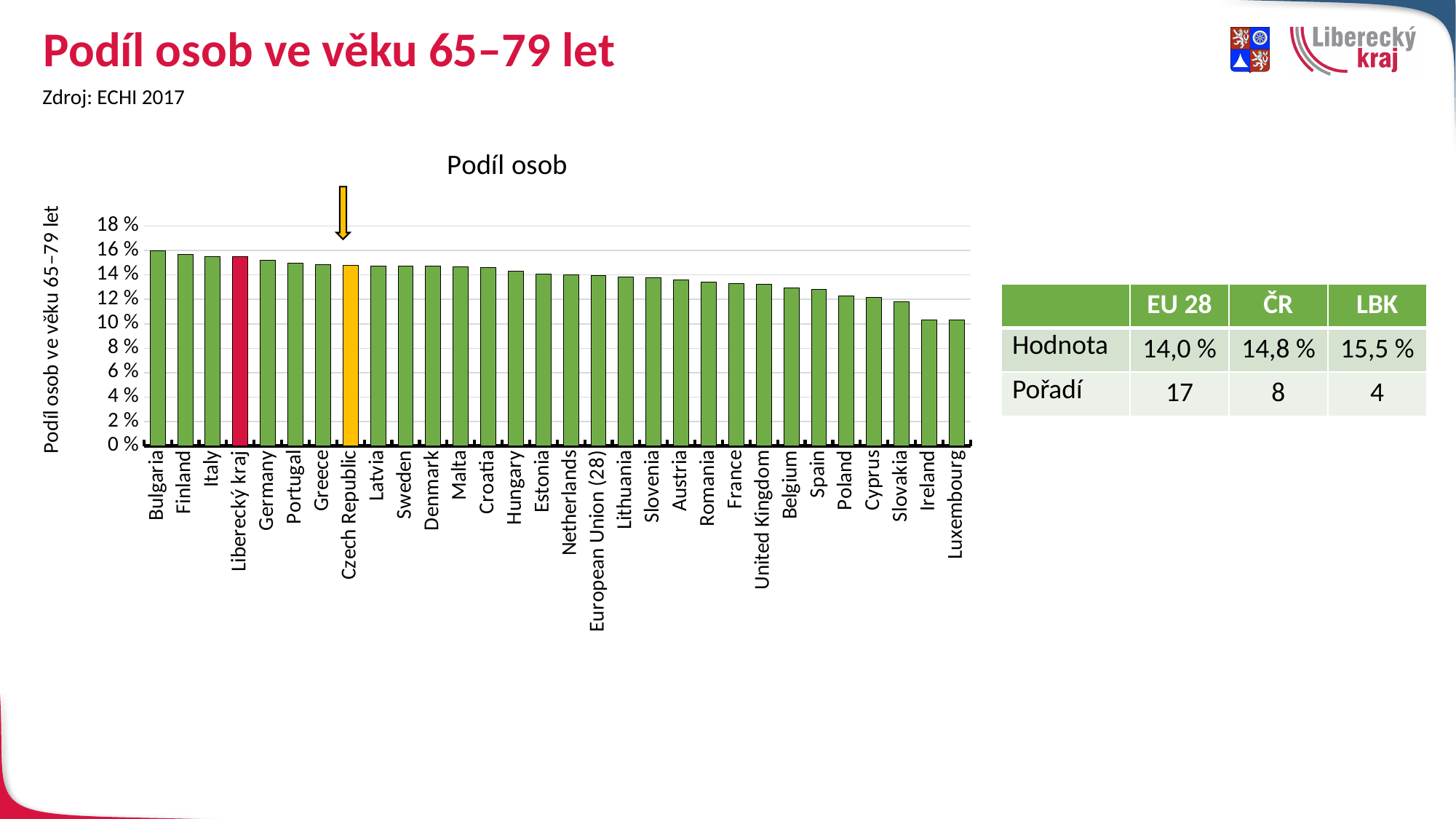
What kind of chart is shown on the slide? bar chart Is the value for Luxembourg greater or less than 12 %? less Which category has the highest bar in the chart? Bulgaria What is the value for Liberecký kraj? 15,5 % What is the value for Czech Republic? 14,8 % Which bar in the chart is coloured red? Liberecký kraj Do the bar values rise or fall from left to right along the x axis? fall What is the title of the chart? Podíl osob How many countries/regions are plotted on the x axis of the chart? 30 What is the value for European Union (28)? 14,0 % Which is larger, the value for Liberecký kraj or the value for Czech Republic? Liberecký kraj What is the difference between the values for Liberecký kraj and Czech Republic? 0,7 %